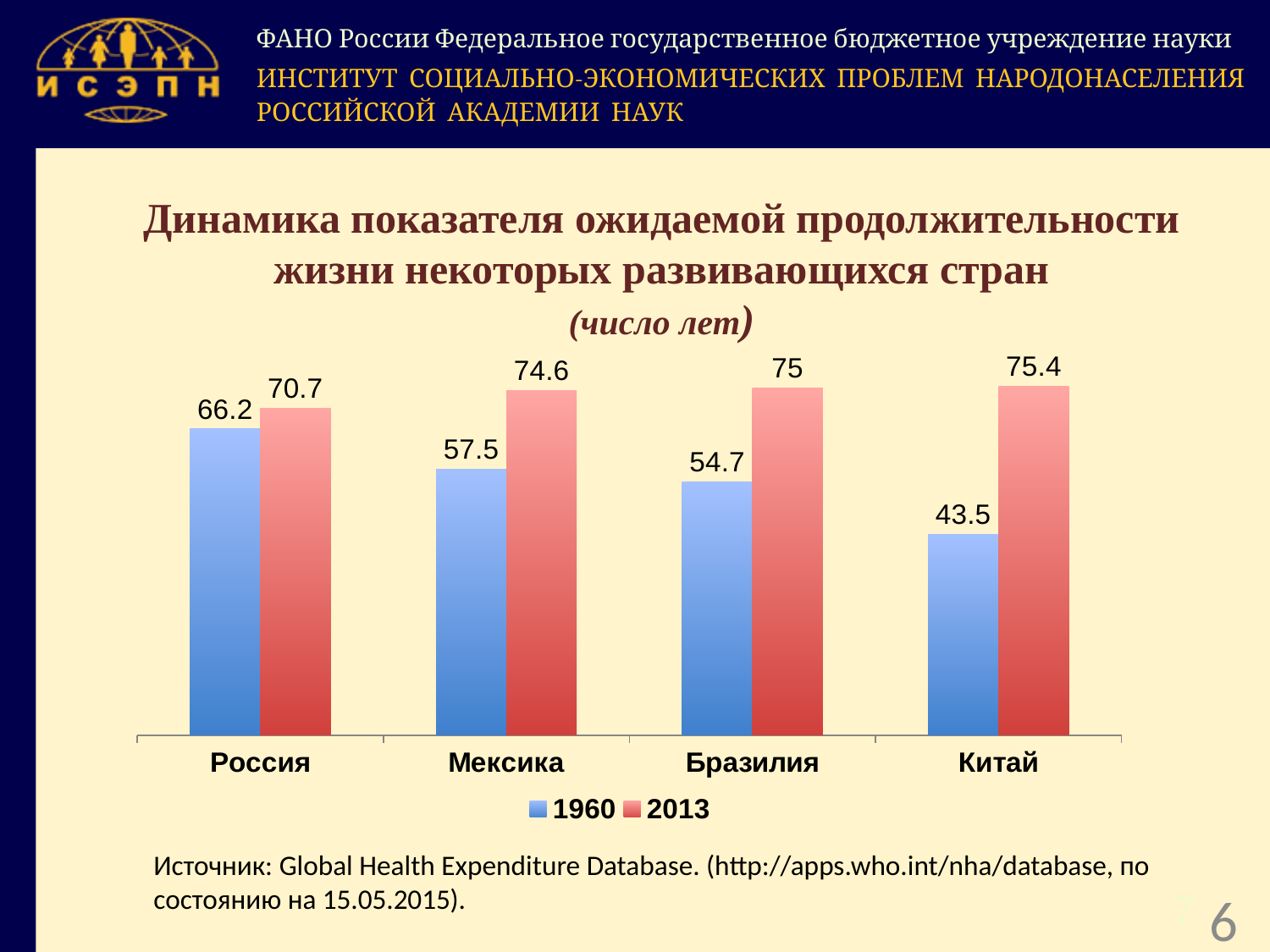
How many series does the legend list? 2 What was the life expectancy in China (Китай) in 2013? 75.4 Which country had the lowest life expectancy in 1960? Китай What type of chart is shown on the slide? bar chart By how much did life expectancy in China (Китай) increase from 1960 to 2013? 31.9 Which country had the highest life expectancy in 1960? Россия Which is larger: the 1960 value for Mexico (Мексика) or the 1960 value for Brazil (Бразилия)? Мексика How many countries are shown on the chart? 4 What is the difference between the 2013 values for Mexico (Мексика) and Russia (Россия)? 3.9 Which colour represents the year 2013 in the chart? red What was the life expectancy in Brazil (Бразилия) in 1960? 54.7 What was the life expectancy in Russia (Россия) in 1960? 66.2